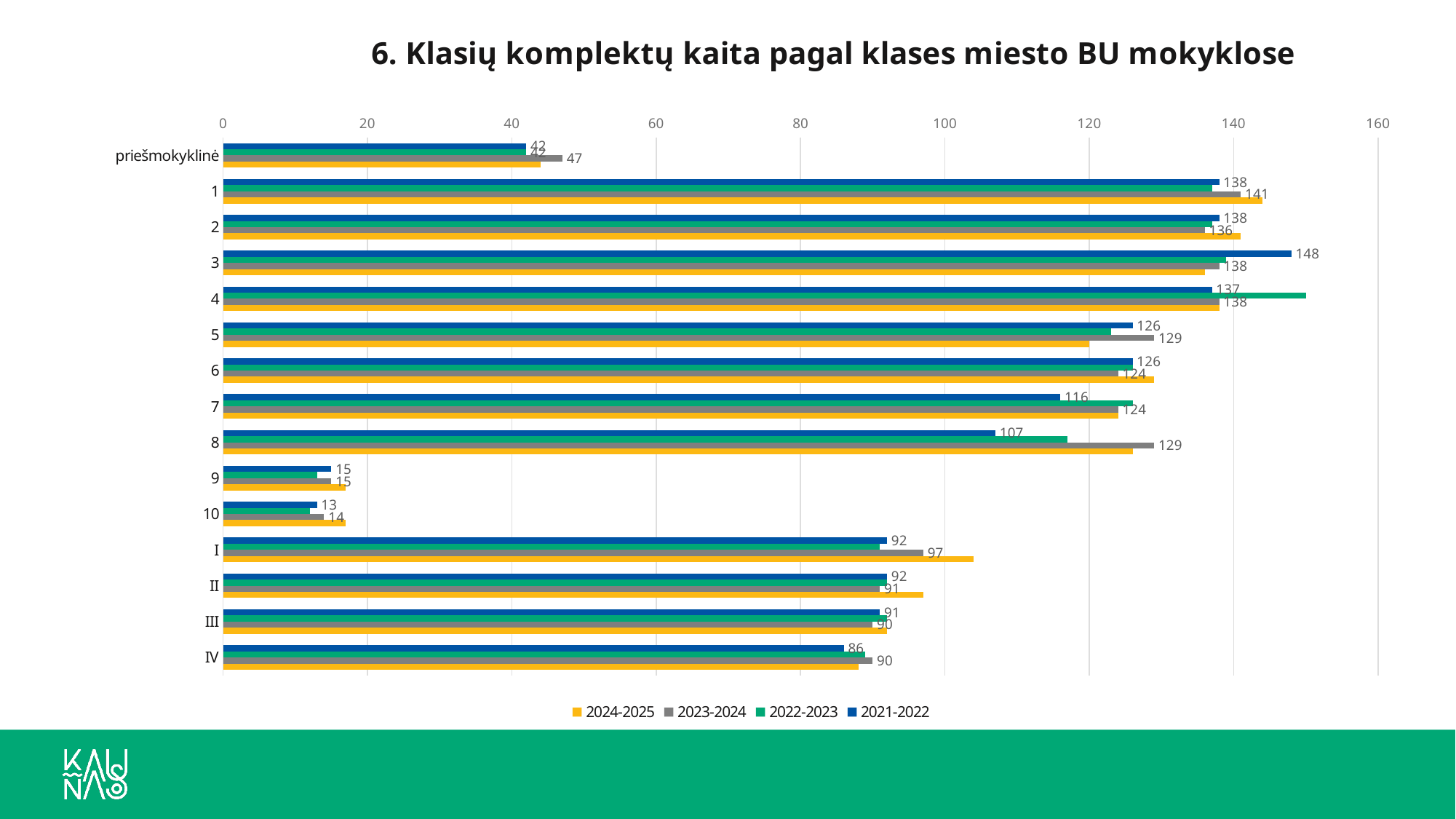
What is the value for class 8 in the 2023-2024 series? 129 What is the value for class 3 in the 2021-2022 series? 148 Which category has the lowest value in the 2021-2022 series? 10 What is the value for priešmokyklinė in the 2023-2024 series? 47 How many categories are shown on the vertical axis? 15 Is the value for class 4 in the 2022-2023 series greater or less than 140? greater How many series does the legend list? 4 What is the value for class IV in the 2021-2022 series? 86 What is the difference between the 2023-2024 and 2021-2022 values for class 8? 22 For class 7, which is larger: the 2023-2024 value or the 2021-2022 value? 2023-2024 What kind of chart is shown on the slide? bar chart Which category has the highest value in the 2021-2022 series? 3